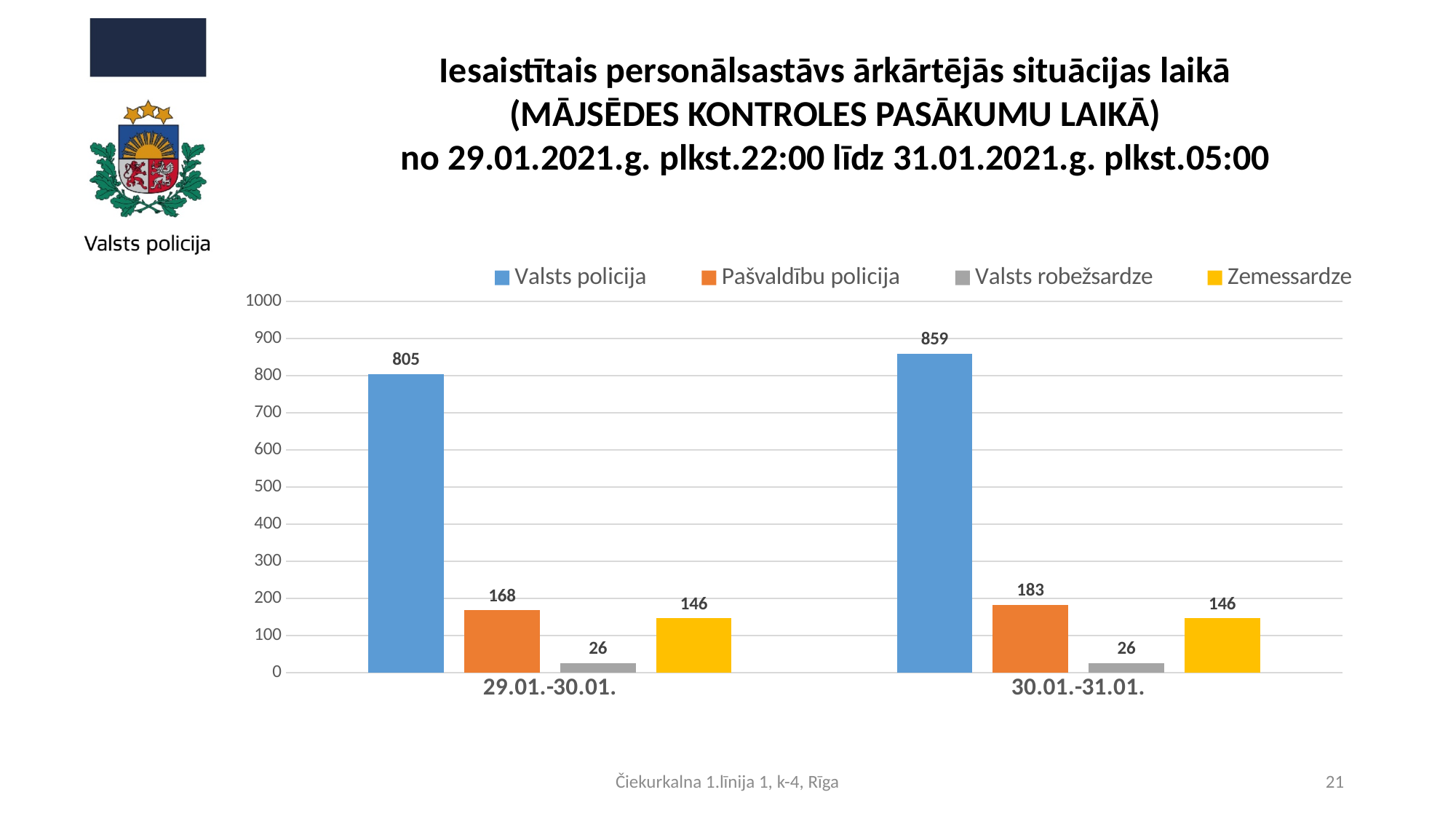
How many series does the legend list? 4 What is the value for Zemessardze in the 29.01.-30.01. period? 146 How many categories are shown on the x axis? 2 What is the difference between the Valsts policija values for 30.01.-31.01. and 29.01.-30.01.? 54 What is the value for Valsts robežsardze in the 30.01.-31.01. period? 26 Which is larger: Pašvaldību policija in 29.01.-30.01. or Zemessardze in 29.01.-30.01.? Pašvaldību policija in 29.01.-30.01. What is the value for Pašvaldību policija in the 30.01.-31.01. period? 183 Does the Pašvaldību policija value rise or fall from 29.01.-30.01. to 30.01.-31.01.? Rise Which series has the highest value in the 30.01.-31.01. period? Valsts policija What is the value for Valsts policija in the 29.01.-30.01. period? 805 Which series has the lowest value in the 29.01.-30.01. period? Valsts robežsardze What kind of chart is shown on the slide? Bar chart